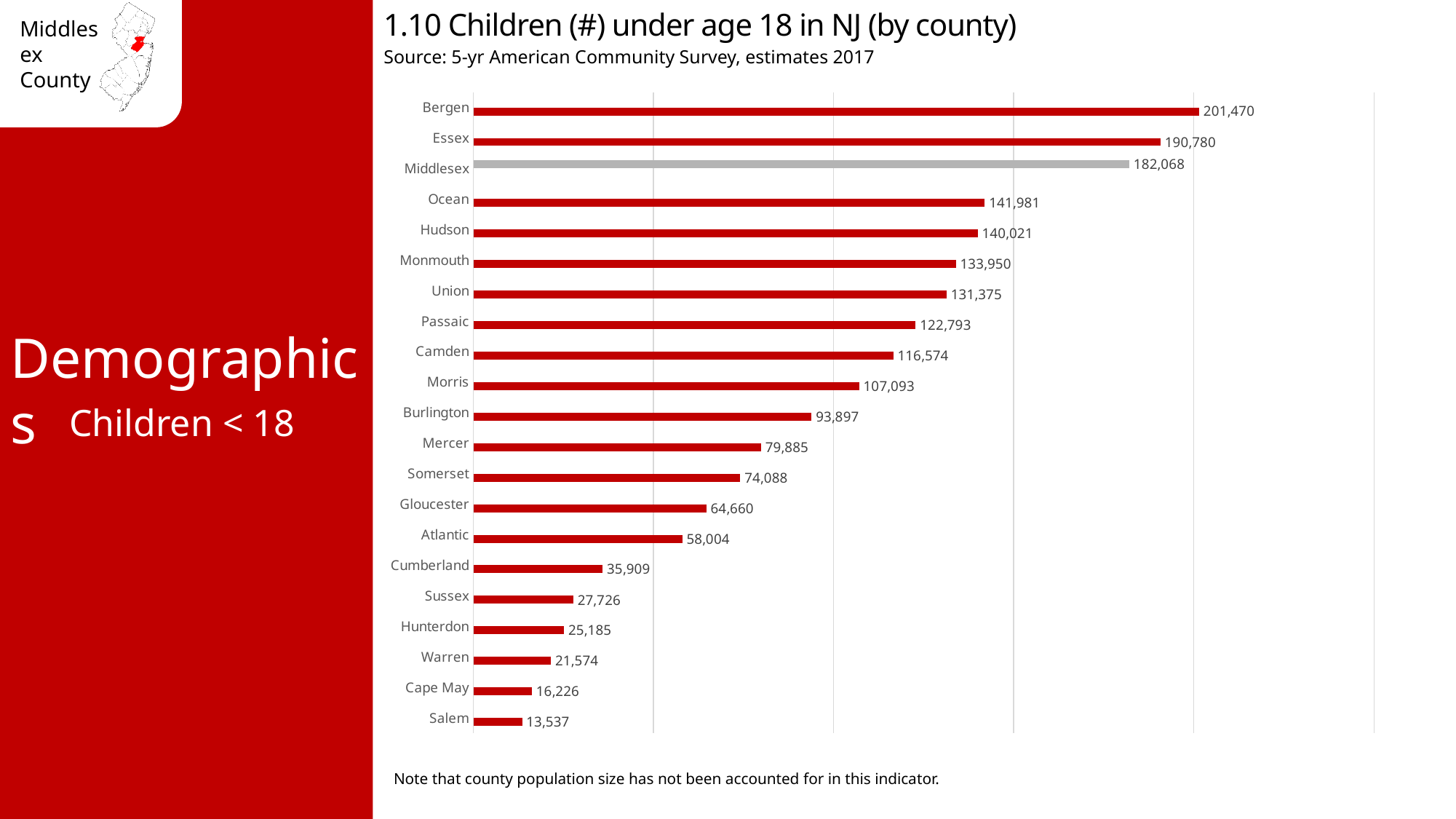
Which county has more children under age 18, Mercer or Somerset? Mercer What type of chart is used on this slide? Bar chart What is the number of children under age 18 in Salem County? 13,537 What is the number of children under age 18 in Middlesex County? 182,068 What is the number of children under age 18 in Ocean County? 141,981 How many counties are shown in the chart? 21 Which county's bar is shown in grey rather than red? Middlesex What is the difference between the number of children under 18 in Bergen and Essex counties? 10,690 Which county has the highest number of children under age 18? Bergen Which county has the lowest number of children under age 18? Salem Which county has more children under age 18, Passaic or Camden? Passaic What is the difference between the number of children under 18 in Middlesex and Ocean counties? 40,087